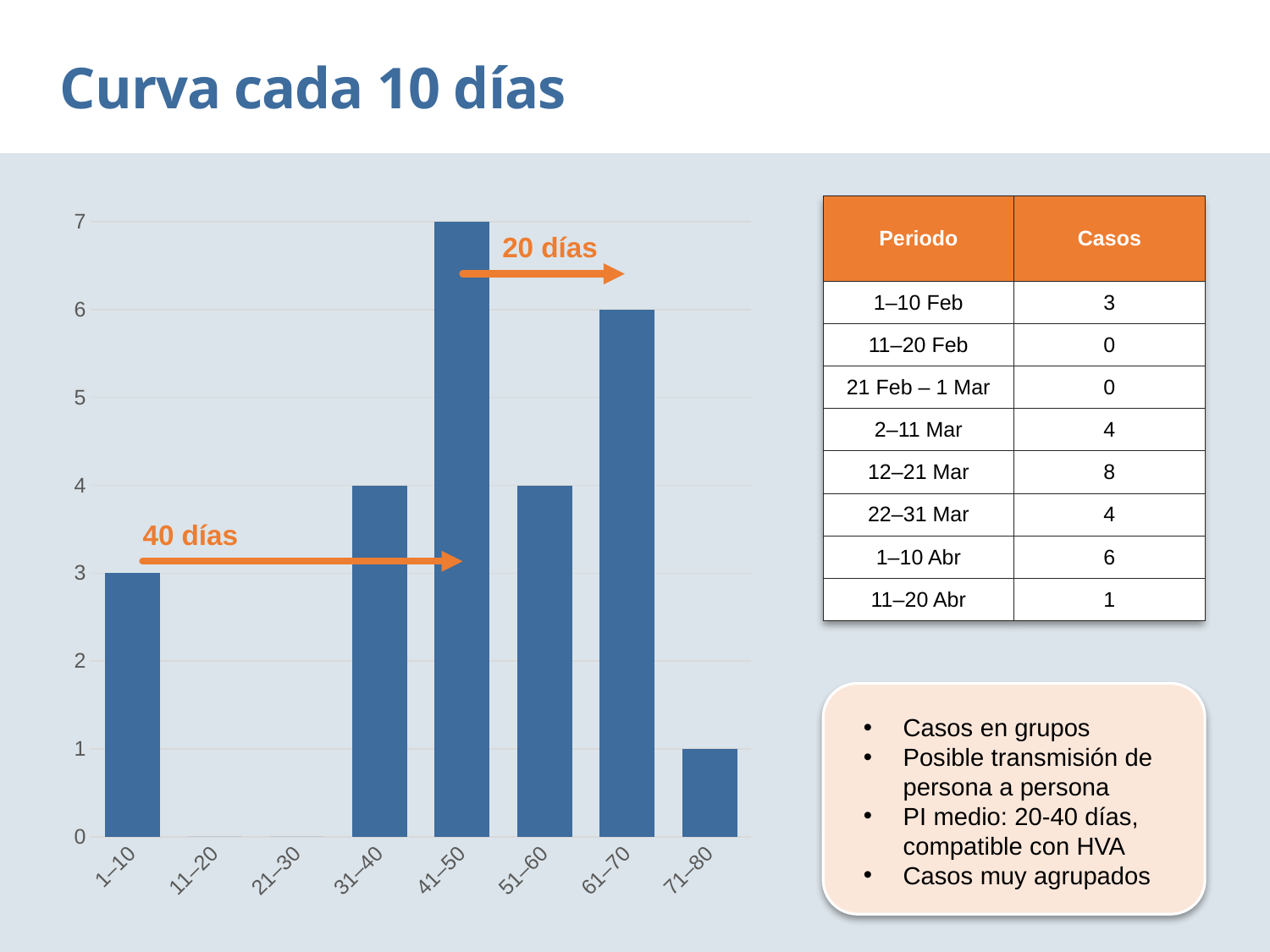
What is the value for the 71–80 category? 1 Is the value for 41–50 greater or less than 5? greater What is the value for the 1–10 category? 3 What is the value for the 61–70 category? 6 What is the difference between the values for 41–50 and 61–70? 1 What is the value for the 41–50 category? 7 Which category has the highest value? 41–50 How many categories have a value of 0? 2 What label is written above the longer orange arrow on the chart? 40 días How many categories are shown on the x axis? 8 What kind of chart is shown on the slide? bar chart Which is larger, the value for 31–40 or the value for 61–70? 61–70